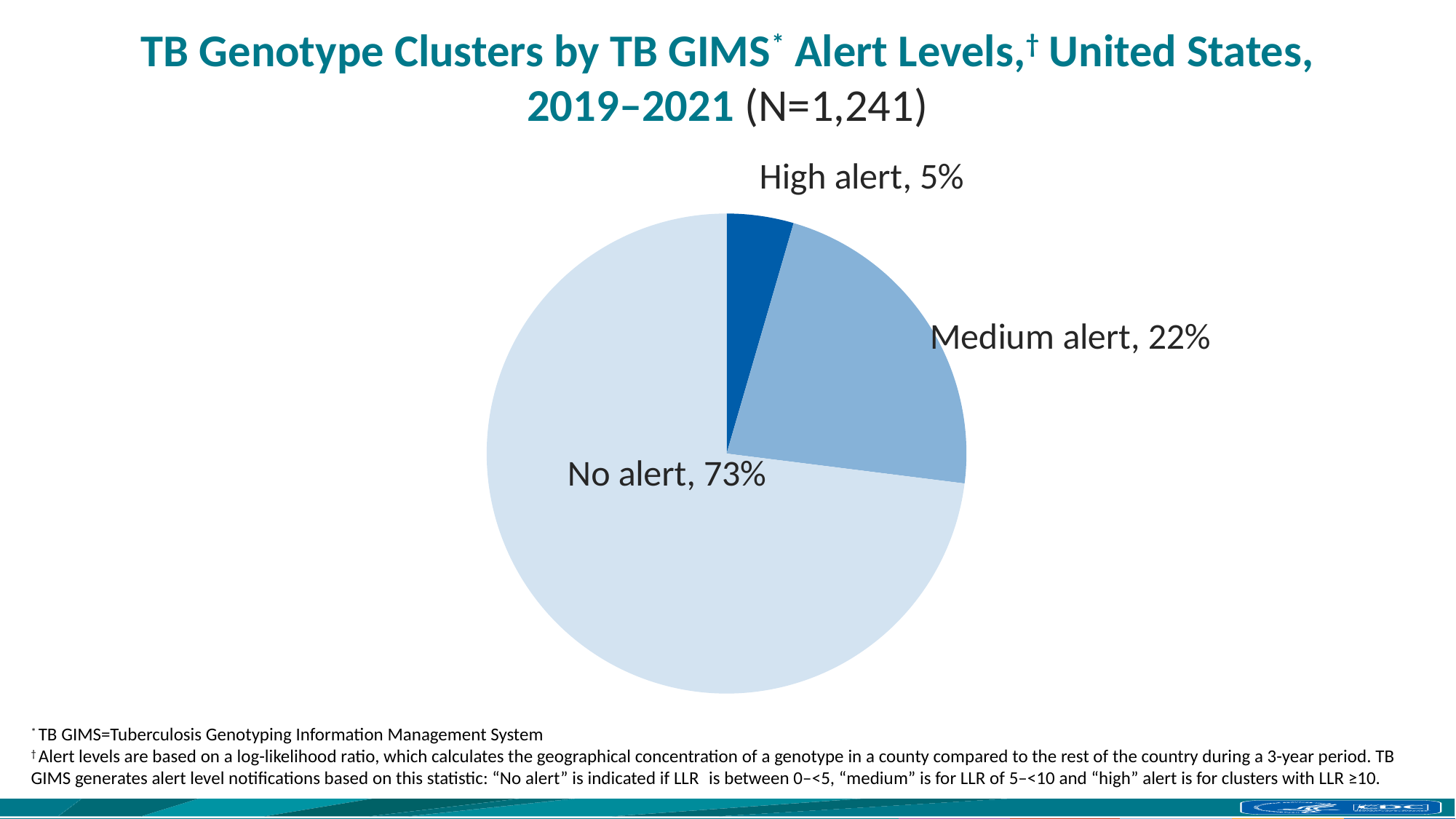
Which is larger, the Medium alert share or the High alert share? Medium alert Which alert level accounts for the largest share of clusters? No alert Which alert level accounts for the smallest share of clusters? High alert How many slices does the pie chart have? 3 What is the difference in percentage points between the Medium alert and High alert shares? 17 What share of TB genotype clusters had no alert? 73% What share of TB genotype clusters had a high alert? 5% What is the difference in percentage points between the No alert and Medium alert shares? 51 What time period does the chart cover? 2019–2021 What share of TB genotype clusters had a medium alert? 22% What type of chart is shown on the slide? pie chart What is the total number of TB genotype clusters (N) given in the chart title? 1,241